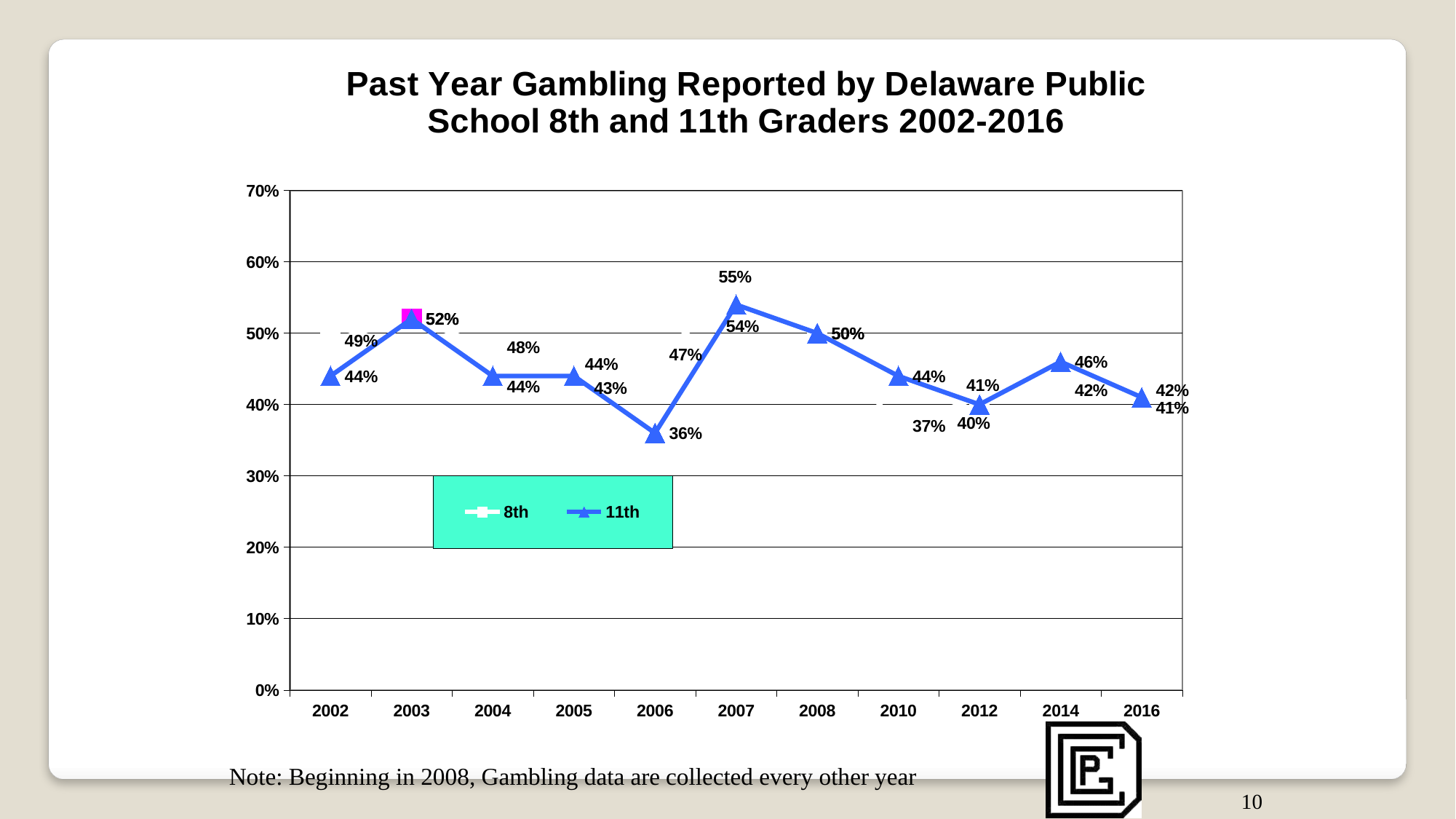
In which year is the 11th grade value the lowest? 2006 What is the value for 8th graders in 2006? 47% What is the value for 11th graders in 2006? 36% What type of chart is shown on the slide? Line chart How many years are shown on the x axis? 11 What is the value for 11th graders in 2014? 46% In 2010, which group has the higher value, 8th or 11th graders? 11th Does the 11th grade value rise or fall from 2007 to 2012? Fall What is the value for 8th graders in 2010? 37% How many series does the legend list? 2 In which year is the 11th grade value the highest? 2007 What is the difference between the 8th and 11th grade values in 2006? 11 percentage points